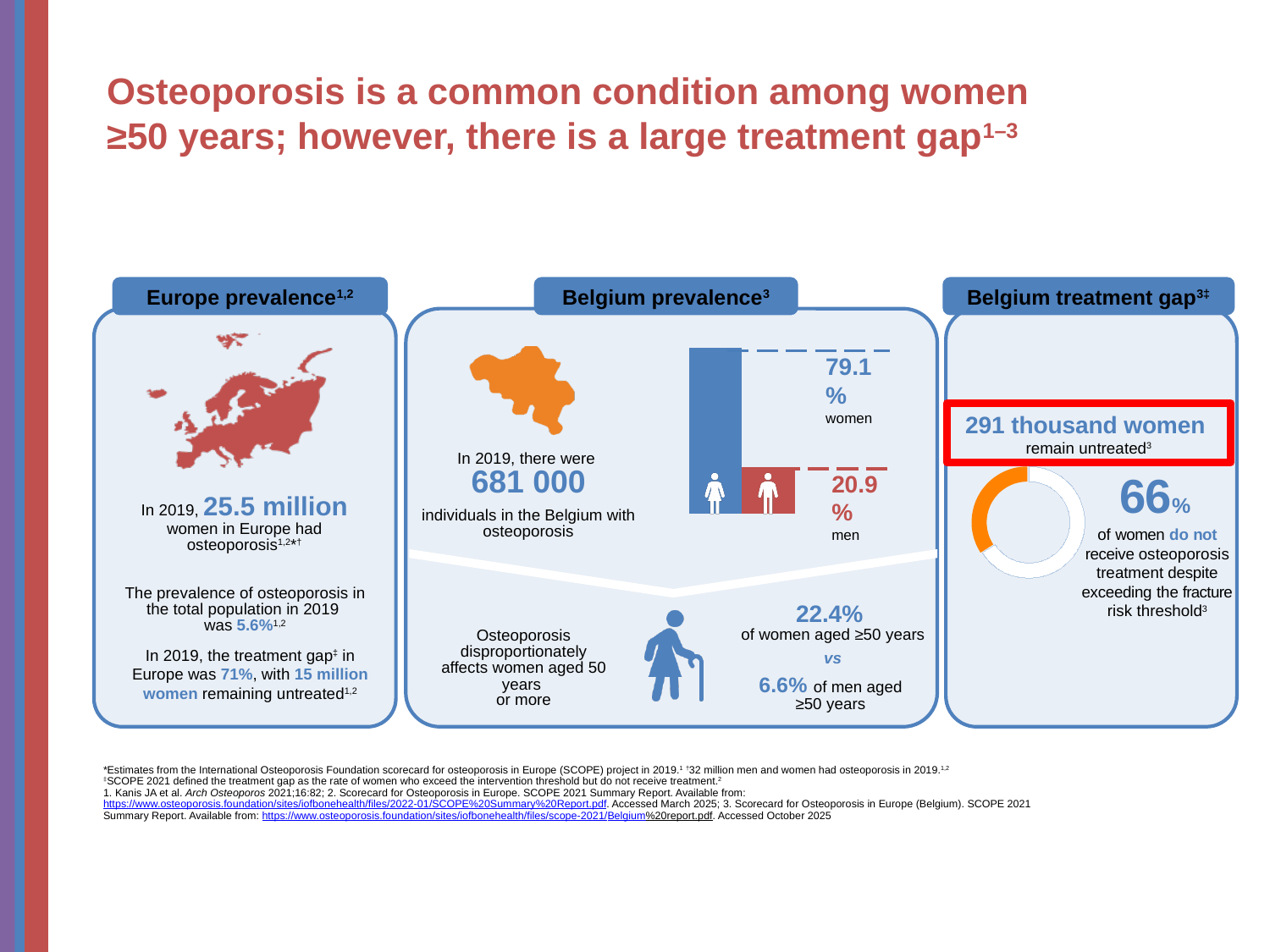
In the bar chart in the Belgium prevalence panel, what is the difference between the women and men percentages? 58.2 percentage points What kind of chart is shown in the Belgium prevalence panel comparing women and men? bar chart In the bar chart in the Belgium prevalence panel, is the value for men greater or less than 50%? less In the bar chart in the Belgium prevalence panel, which group has the taller bar, women or men? women In the bar chart in the Belgium prevalence panel, what percentage is shown for women? 79.1% What kind of chart is shown in the Belgium treatment gap panel? donut (pie) chart In the donut chart in the Belgium treatment gap panel, what does the 66% represent? women who do not receive osteoporosis treatment despite exceeding the fracture risk threshold In the bar chart in the Belgium prevalence panel, what colour is the bar for women? blue In the bar chart in the Belgium prevalence panel, what percentage is shown for men? 20.9% How many bars are in the bar chart in the Belgium prevalence panel? 2 In the bar chart in the Belgium prevalence panel, which category has the lowest value? men